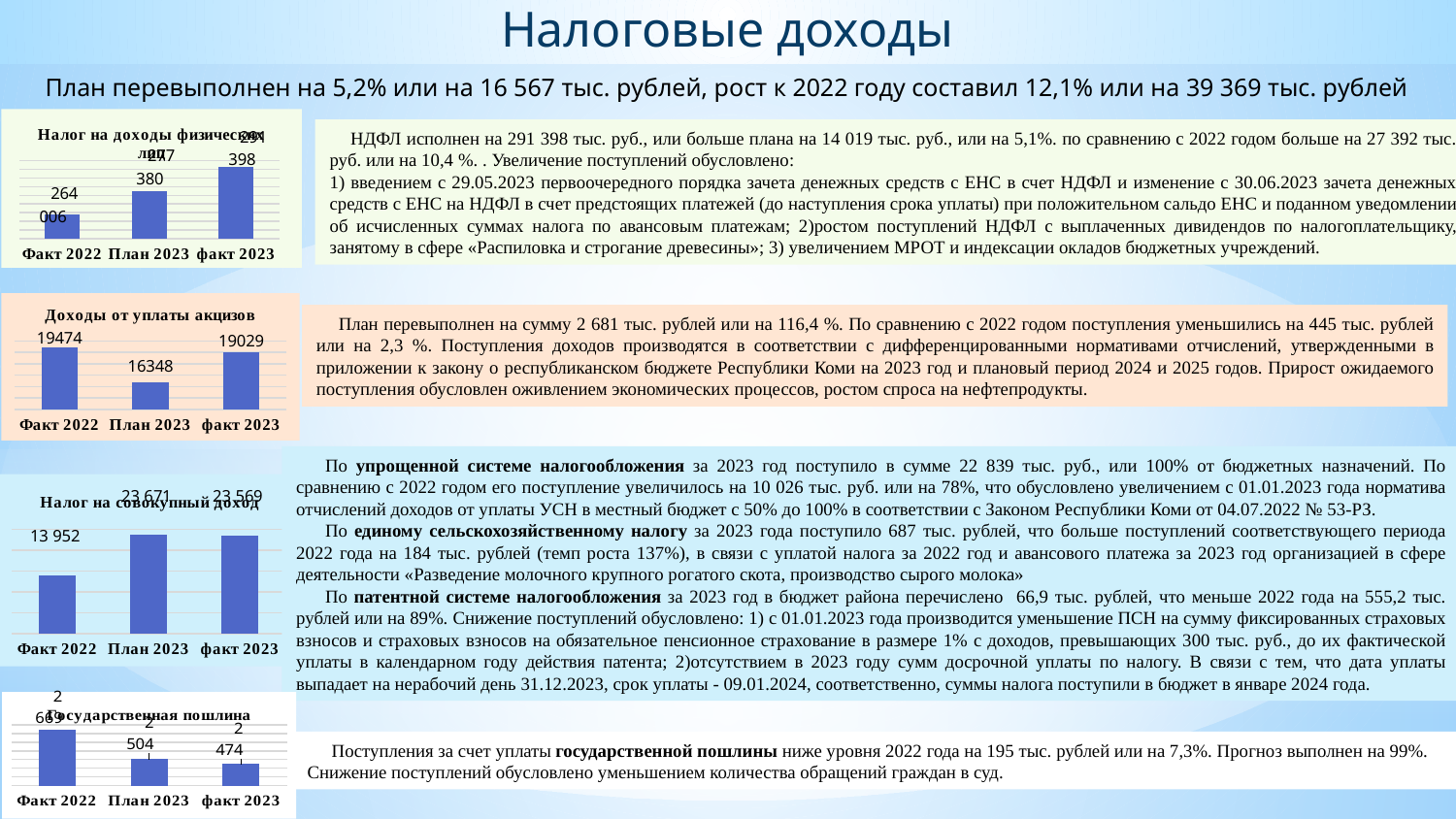
In the chart titled "Налог на совокупный доход", what is the value for Факт 2022? 13 952 In the chart titled "Доходы от уплаты акцизов", what is the difference between Факт 2022 and План 2023? 3126 In the chart titled "Государственная пошлина", what is the difference between План 2023 and факт 2023? 30 How many categories are shown in the chart titled "Доходы от уплаты акцизов"? 3 In the chart titled "Налог на доходы физических лиц", which category has the highest bar? факт 2023 In the chart titled "Государственная пошлина", what is the value for План 2023? 2 504 In the chart titled "Доходы от уплаты акцизов", what is the value for Факт 2022? 19474 In the chart titled "Налог на совокупный доход", which category has the lowest value? Факт 2022 In the chart titled "Государственная пошлина", what is the value for факт 2023? 2 474 In the chart titled "Доходы от уплаты акцизов", which category has the lowest value? План 2023 In the chart titled "Государственная пошлина", which category has the highest value? Факт 2022 In the chart titled "Доходы от уплаты акцизов", what is the value for План 2023? 16348